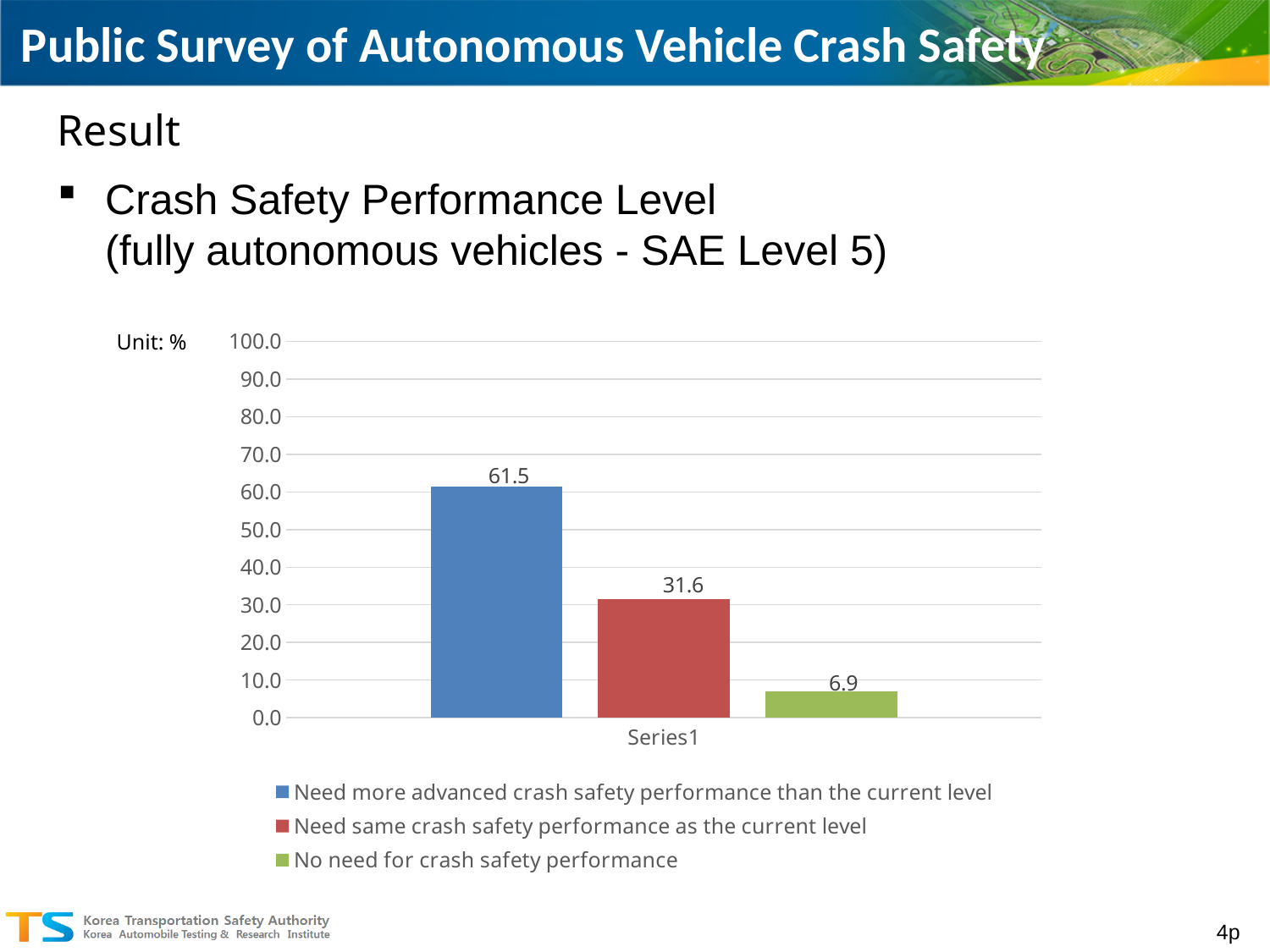
What kind of chart is shown on the slide? bar chart What is the value for 'Need same crash safety performance as the current level'? 31.6 What is the difference between the values for 'Need more advanced crash safety performance than the current level' and 'Need same crash safety performance as the current level'? 29.9 Which is larger: the value for 'Need same crash safety performance as the current level' or 'No need for crash safety performance'? Need same crash safety performance as the current level What is the value for 'No need for crash safety performance'? 6.9 Is the value for 'Need more advanced crash safety performance than the current level' greater or less than 50.0? greater Which response has the lowest value? No need for crash safety performance What unit is indicated for the chart values? % Which response has the highest value? Need more advanced crash safety performance than the current level What is the value for 'Need more advanced crash safety performance than the current level'? 61.5 How many series does the legend list? 3 What is the difference between the values for 'Need same crash safety performance as the current level' and 'No need for crash safety performance'? 24.7